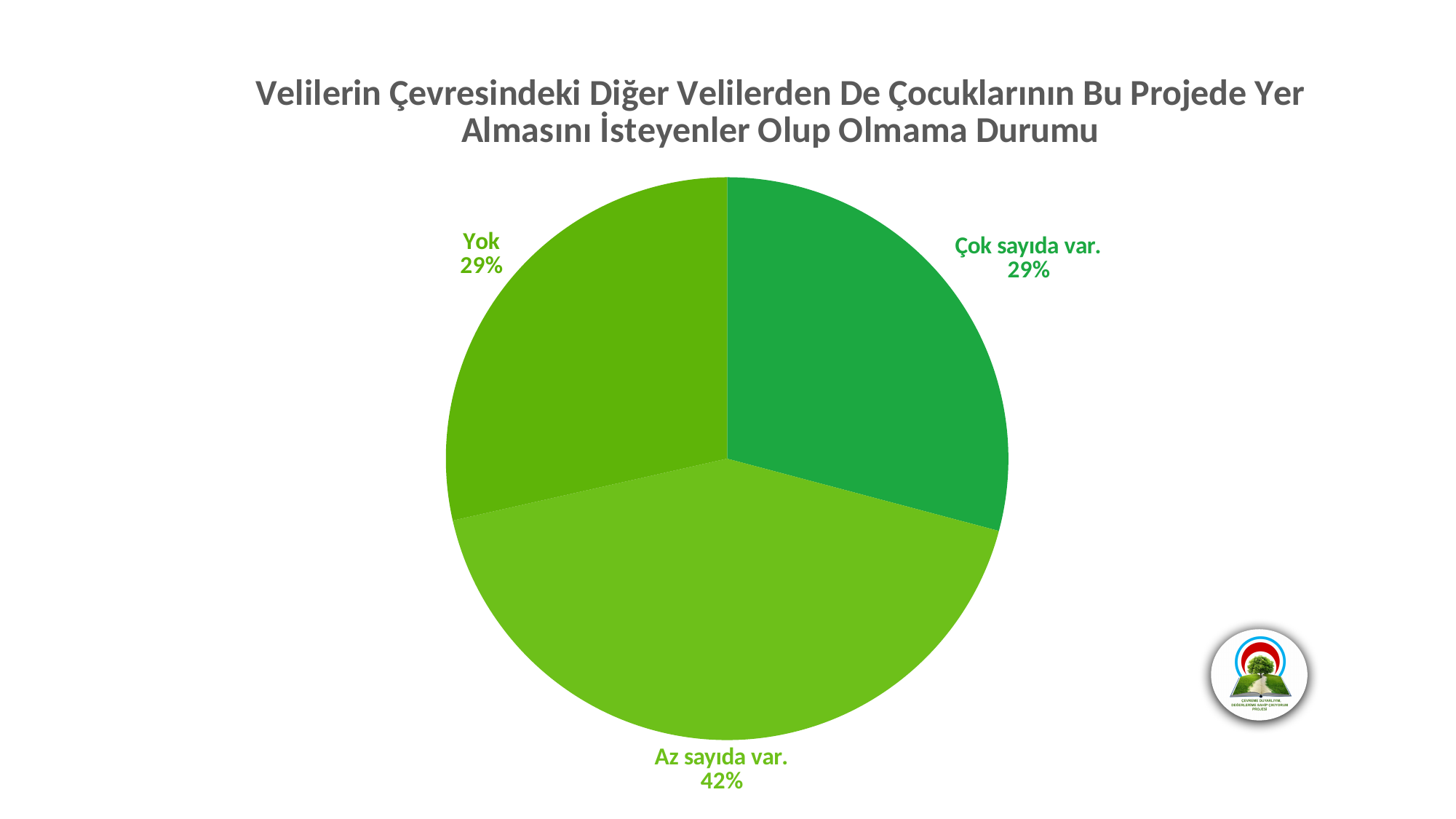
What share of the pie does "Az sayıda var." represent? 42% Do "Yok" and "Çok sayıda var." have the same percentage? Yes Which category has the largest slice of the pie? Az sayıda var. Which is larger, the slice for "Az sayıda var." or the slice for "Çok sayıda var."? Az sayıda var. How many slices does the pie chart have? 3 What is the difference in percentage points between "Az sayıda var." and "Yok"? 13 What share of the pie does "Çok sayıda var." represent? 29% What type of chart is shown on the slide? Pie chart What is the title of the chart? Velilerin Çevresindeki Diğer Velilerden De Çocuklarının Bu Projede Yer Almasını İsteyenler Olup Olmama Durumu What share of the pie does "Yok" represent? 29% Which category's label appears at the bottom of the pie chart? Az sayıda var. What is the combined share of "Yok" and "Çok sayıda var."? 58%